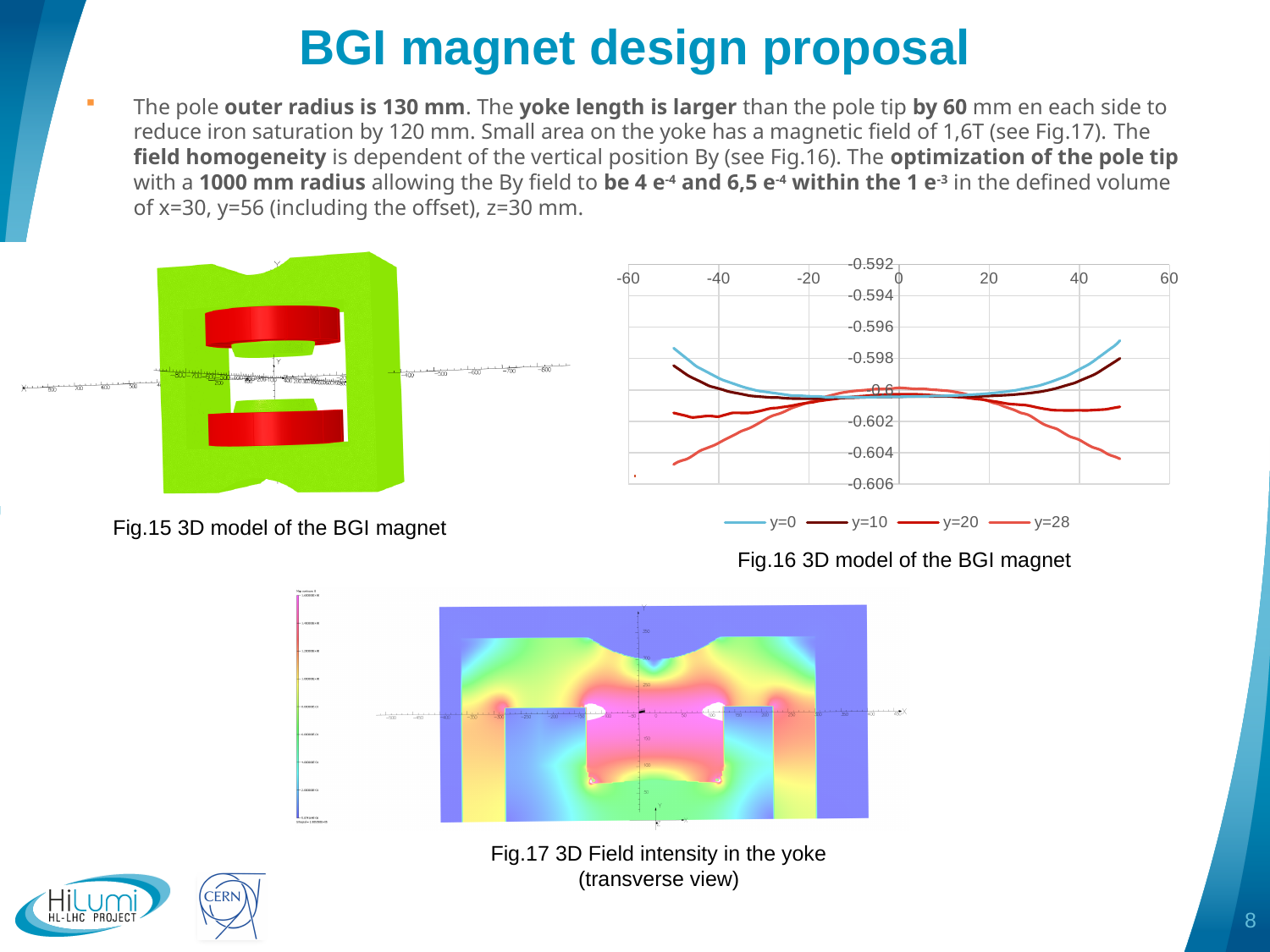
In Fig.16, is the value of the y=28 series at x=50 greater or less than -0.602? less In Fig.16, how many series does the legend list? 4 In Fig.16, at x=50, which series has the higher value, y=0 or y=28? y=0 In Fig.16, is the value of the y=20 series at x=-50 greater or less than -0.6? less In Fig.16, what are the legend entries? y=0, y=10, y=20, y=28 What kind of chart is Fig.16? line chart In Fig.16, which series reaches the highest value on the chart? y=0 In Fig.16, does the y=0 series rise or fall as x goes from 0 to 50? rise In Fig.16, at x=-50, which series has the higher value, y=10 or y=20? y=10 In Fig.16, which series reaches the lowest value on the chart? y=28 In Fig.16, is the value of the y=0 series at x=50 greater or less than -0.598? greater In Fig.16, what is the lowest value shown on the vertical axis? -0.606